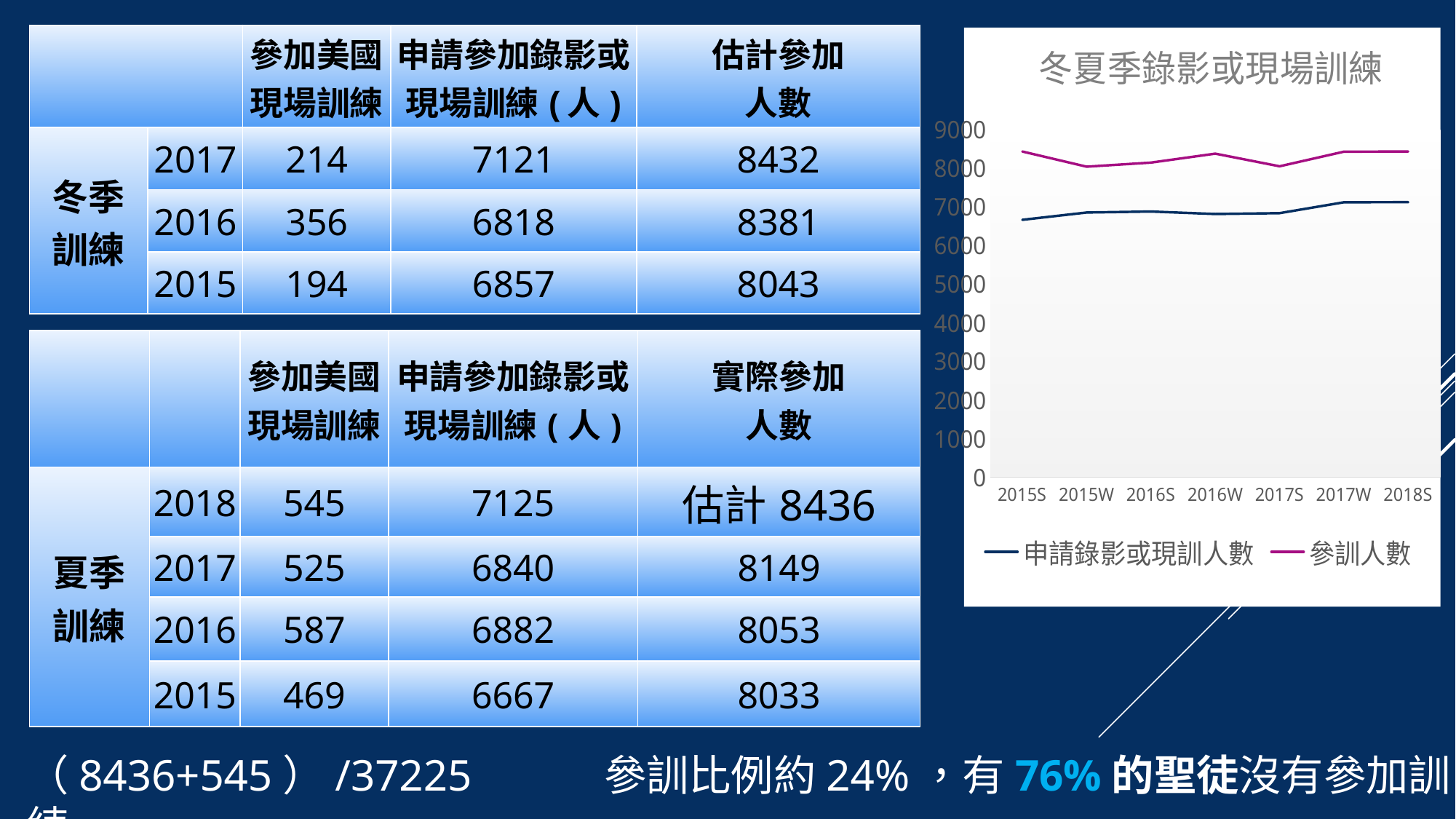
What is the first x-axis label on the chart? 2015S In the chart, does the 申請錄影或現訓人數 line rise or fall overall from 2015S to 2018S? rise In the chart, is the value of 參訓人數 at 2016S greater or less than 7000? greater What is the title of the chart on the slide? 冬夏季錄影或現場訓練 How many series does the chart's legend list? 2 In the chart, which series has the higher value at 2016W, 申請錄影或現訓人數 or 參訓人數? 參訓人數 In the chart, is the value of 申請錄影或現訓人數 at 2015S greater or less than 7000? less How many points are plotted along the x axis of the chart? 7 In the chart, is the value of 參訓人數 at 2017W greater or less than 8000? greater Which series is drawn in magenta in the chart? 參訓人數 What kind of chart is shown on the right side of the slide? line chart